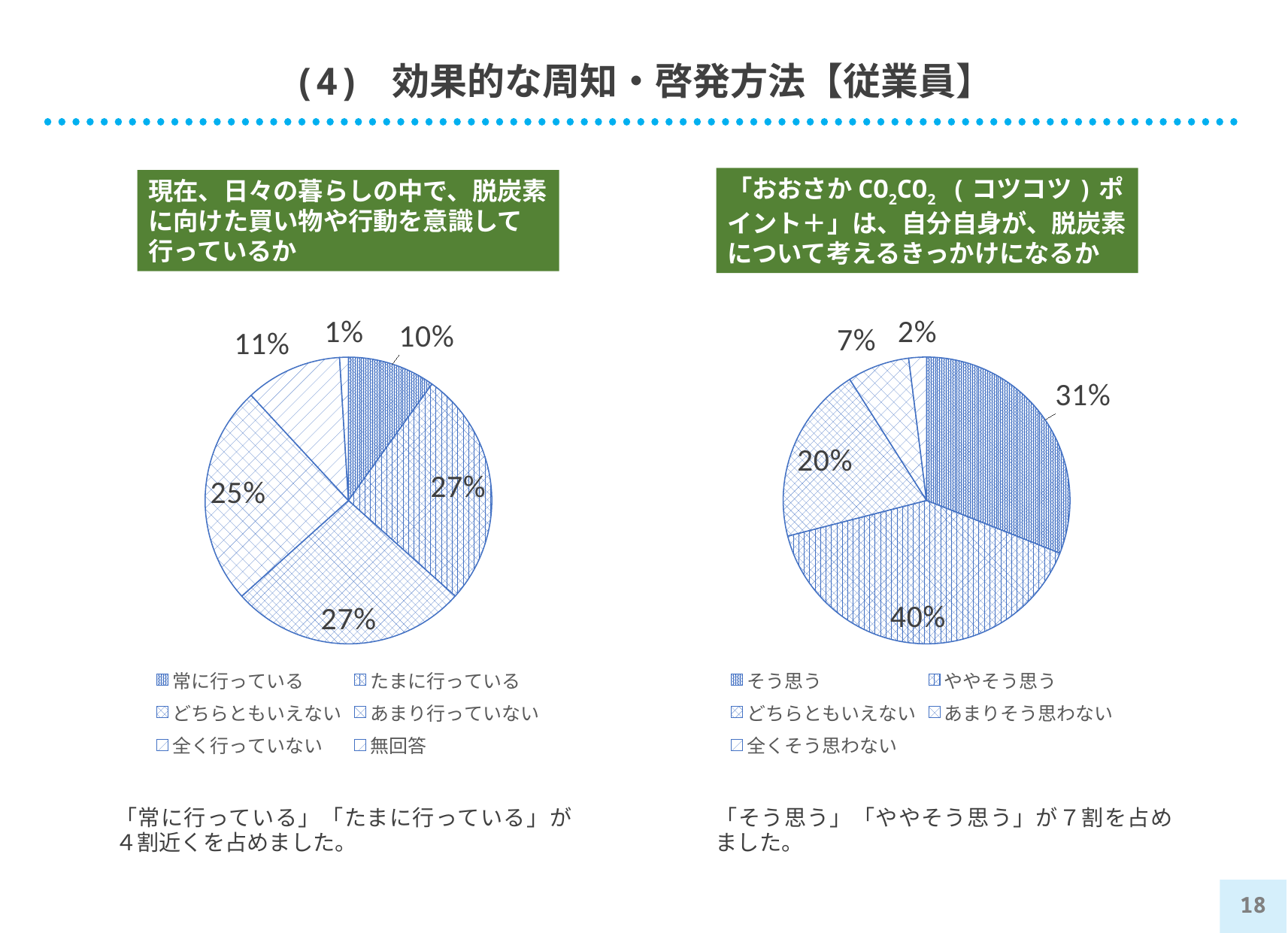
What type of chart is used on the right side of the slide? Pie chart In the right pie chart, which category has the largest share? ややそう思う In the left pie chart, what is the difference between the shares for あまり行っていない and 常に行っている? 15% In the right pie chart, how many categories does the legend list? 5 In the left pie chart, what share is labelled for 無回答? 1% In the left pie chart, which category has the smallest share? 無回答 In the left pie chart, what share is labelled for 常に行っている? 10% In the right pie chart, which is larger, the share for どちらともいえない or the share for あまりそう思わない? どちらともいえない In the right pie chart, what share is labelled for ややそう思う? 40% In the right pie chart, what share is labelled for そう思う? 31% In the left pie chart, how many categories does the legend list? 6 In the left pie chart, what share is labelled for 全く行っていない? 11%